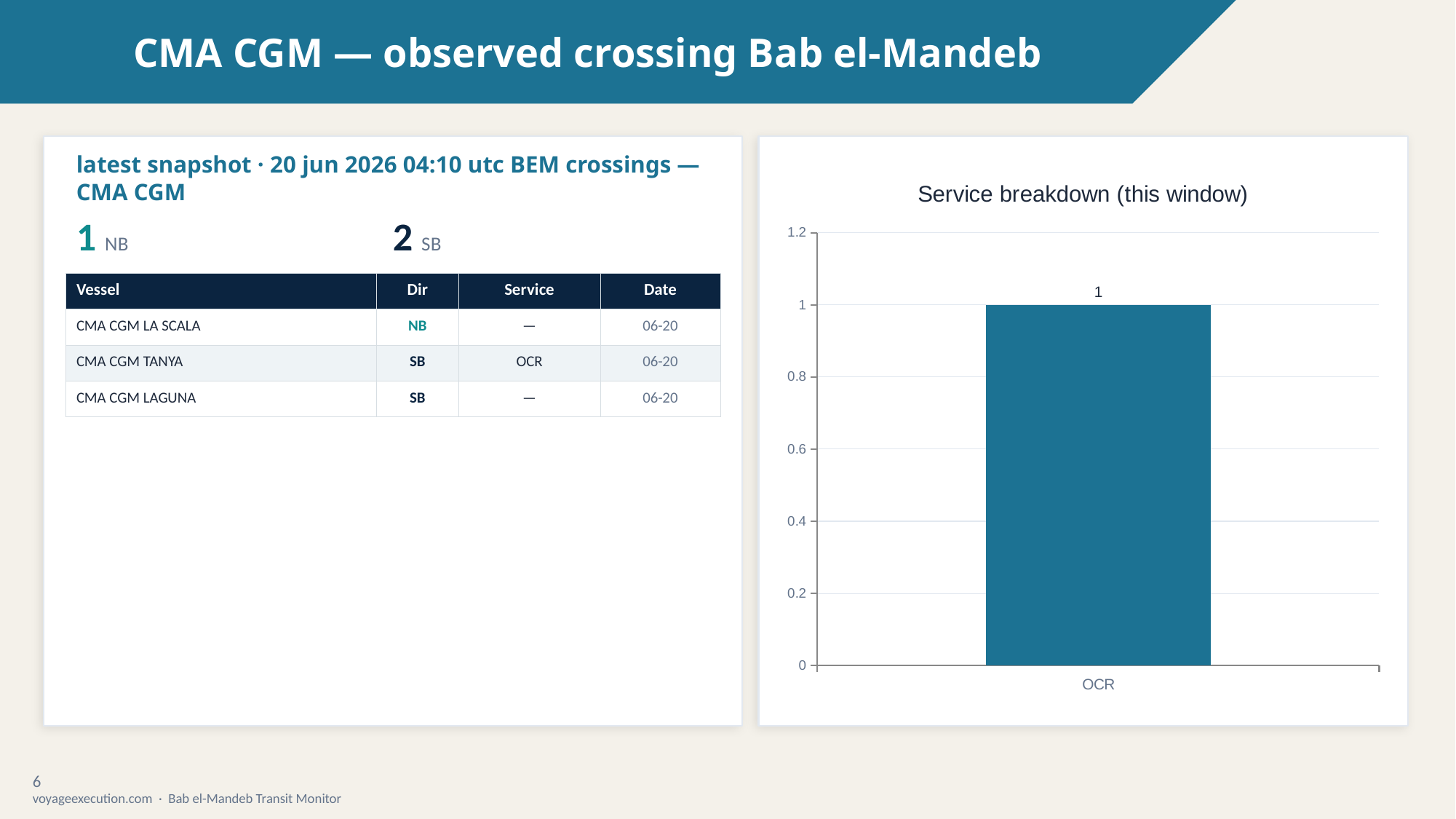
How many categories are plotted in the Service breakdown chart? 1 Is the value for OCR greater or less than 1.2? less Is the value for OCR greater or less than 0.8? greater Which category is shown on the x axis of the Service breakdown chart? OCR What is the highest value shown on the y axis of the Service breakdown chart? 1.2 What is the value for OCR in the Service breakdown chart? 1 What is the title of the chart on the slide? Service breakdown (this window) What kind of chart is the Service breakdown chart? bar chart